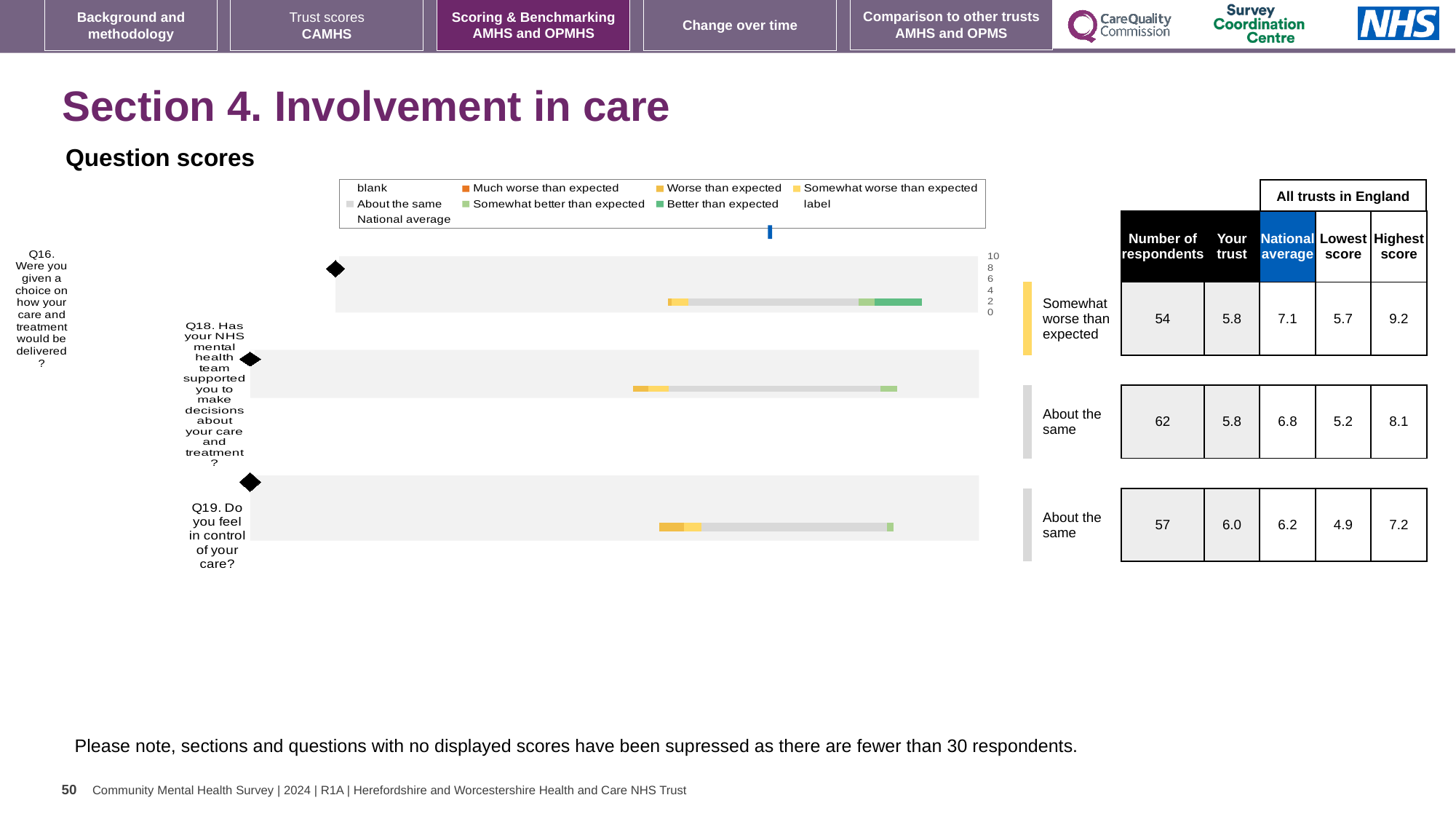
Which question has the lowest national average? Q19 Which question has the highest 'Your trust' score? Q19 What is the 'Your trust' score for Q19 (Do you feel in control of your care?)? 6.0 What is the highest score across all trusts in England for Q19? 7.2 What is the title of the chart on this slide? Question scores How many questions are plotted in the Question scores chart? 3 What kind of chart is used to show the question scores on this slide? Bar chart What is the difference between the highest score and the lowest score for Q16? 3.5 What benchmark category is shown for Q16 (Were you given a choice on how your care and treatment would be delivered?)? Somewhat worse than expected Which has the larger national average, Q16 or Q19? Q16 In the table next to the chart, what is the number of respondents for Q16 (Were you given a choice on how your care and treatment would be delivered?)? 54 What is the national average for Q18 (Has your NHS mental health team supported you to make decisions about your care and treatment?)? 6.8